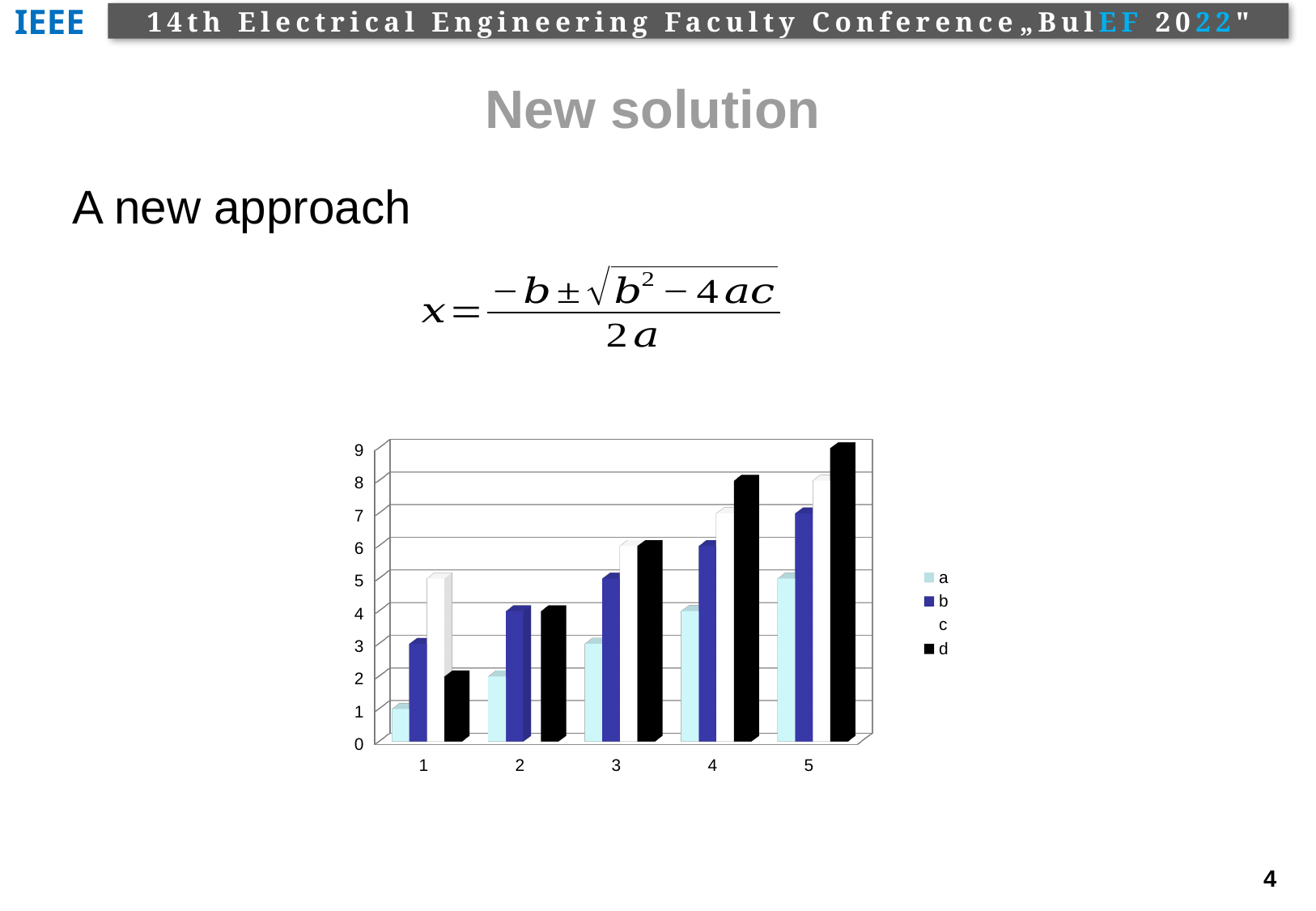
Which category has the highest value for series d? 5 What kind of chart is shown on the slide? bar chart How many categories are shown on the x axis of the chart? 5 What is the value of series a at category 1? 1 What is the value of series d at category 5? 9 What is the value of series b at category 3? 5 Is the value of series d at category 4 greater or less than 5? greater What colour are the bars for series d? black Which category has the lowest value for series a? 1 Do the values of series a rise or fall from category 1 to category 5? rise At category 1, which is larger, series b or series d? b How many series does the chart legend list? 4